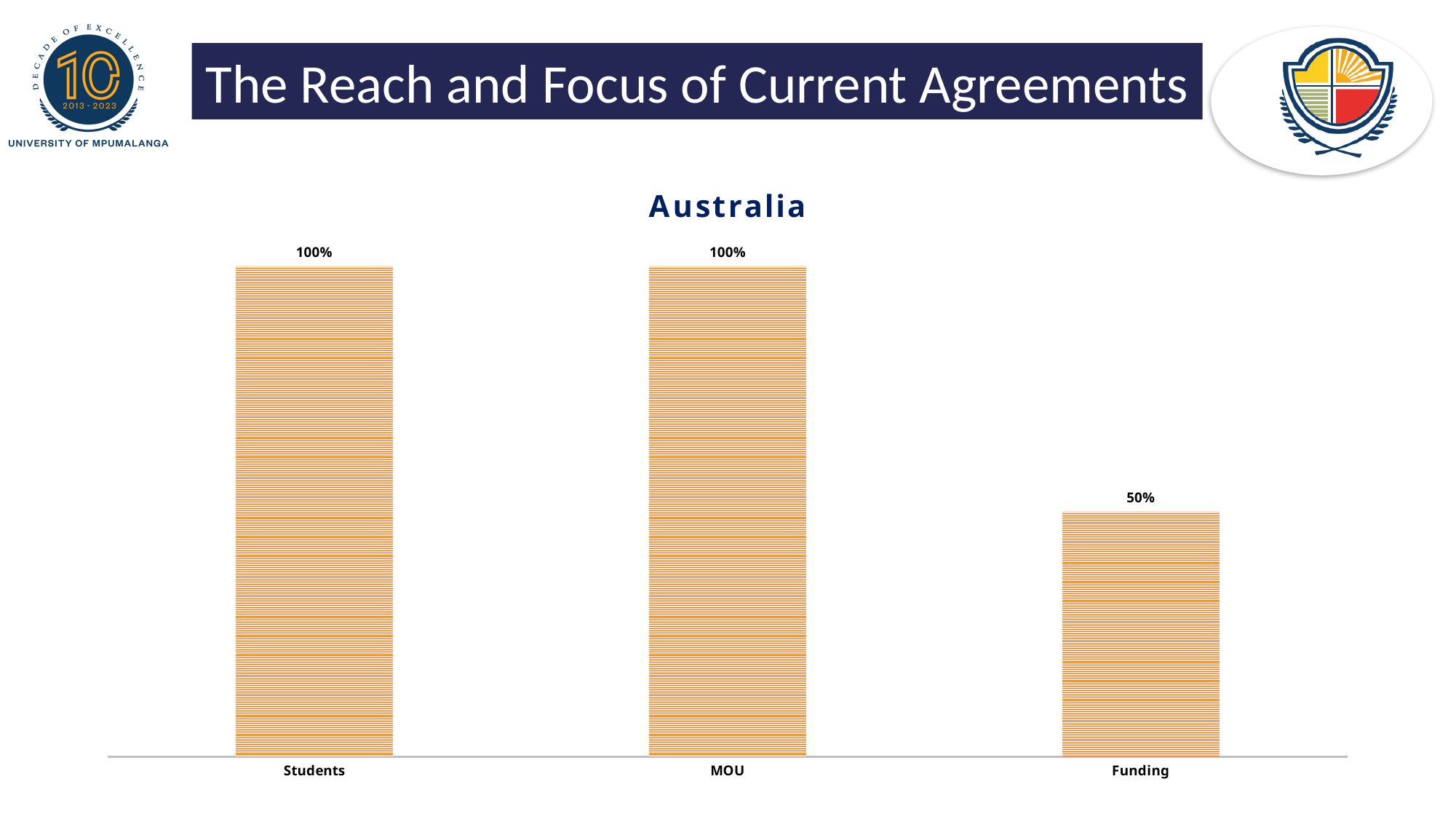
Which is larger, the value for MOU or the value for Funding? MOU Which category has the lowest value? Funding What is the value for MOU? 100% What is the value for Students? 100% What is the title of the chart? Australia What colour are the bars on the chart? Orange What is the value for Funding? 50% Do Students and MOU have the same value? Yes What is the difference between the values for Students and Funding? 50% What kind of chart is shown on the slide? Bar chart Do the values rise or fall from Students to Funding along the x axis? Fall How many categories are shown on the chart? 3